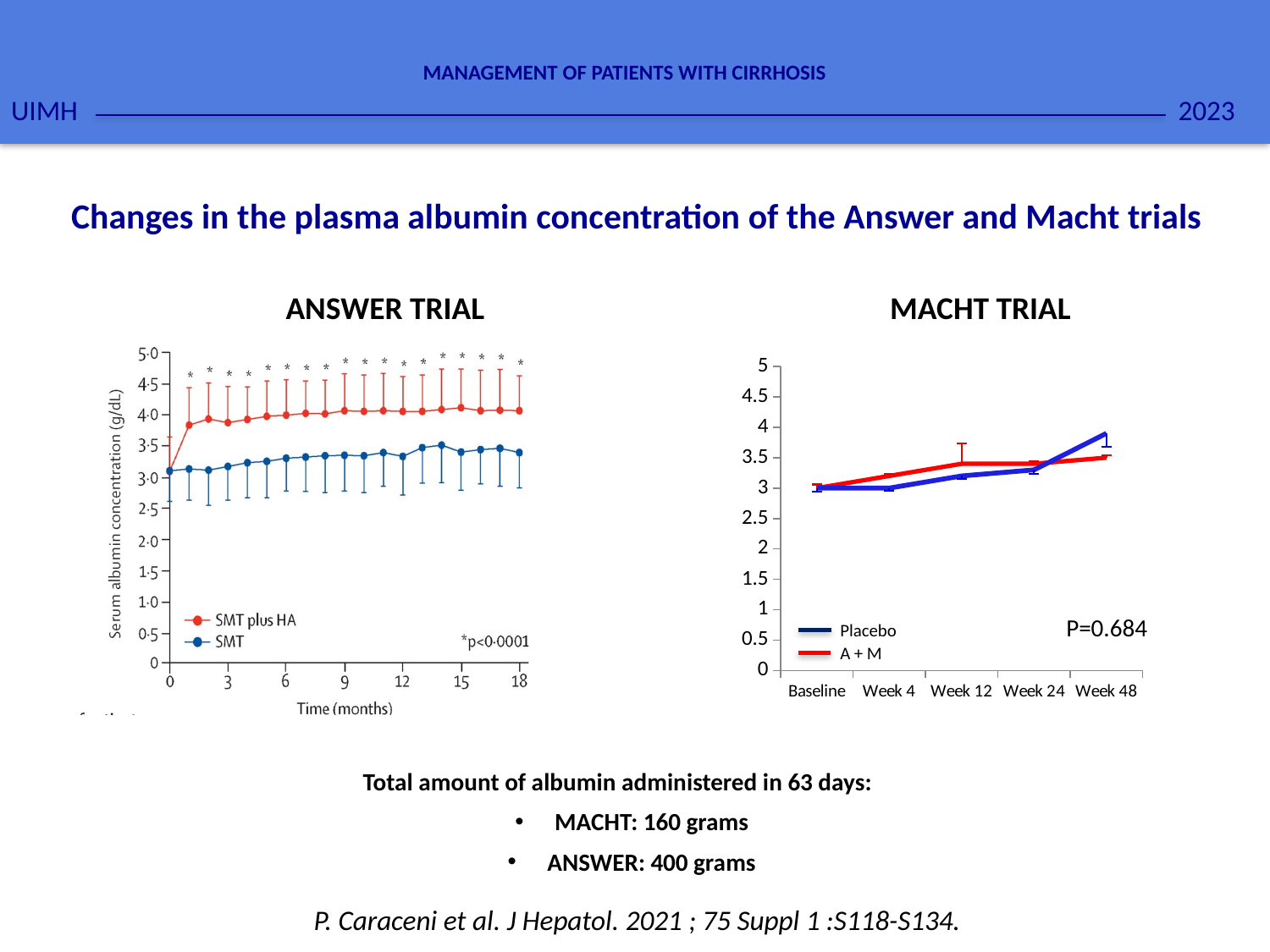
What P value is shown on the MACHT TRIAL chart? P=0.684 How many series does the legend of the MACHT TRIAL chart list? 2 In the MACHT TRIAL chart, which series has the higher value at Week 48, Placebo or A + M? Placebo How many series does the legend of the ANSWER TRIAL chart list? 2 In the ANSWER TRIAL chart, which series has the higher value at 18 months, SMT plus HA or SMT? SMT plus HA What is the y-axis label of the ANSWER TRIAL chart? Serum albumin concentration (g/dL) How many time points are plotted along the x axis of the MACHT TRIAL chart? 5 In the ANSWER TRIAL chart, is the SMT plus HA value at 18 months greater or less than 3.5? greater In the MACHT TRIAL chart, is the Placebo value at Week 48 greater or less than 3.5? greater In the MACHT TRIAL chart, does the Placebo series rise or fall from Baseline to Week 48? rise In the MACHT TRIAL chart, is the Placebo value at Week 4 greater or less than 3.5? less What kind of chart is the MACHT TRIAL chart? line chart